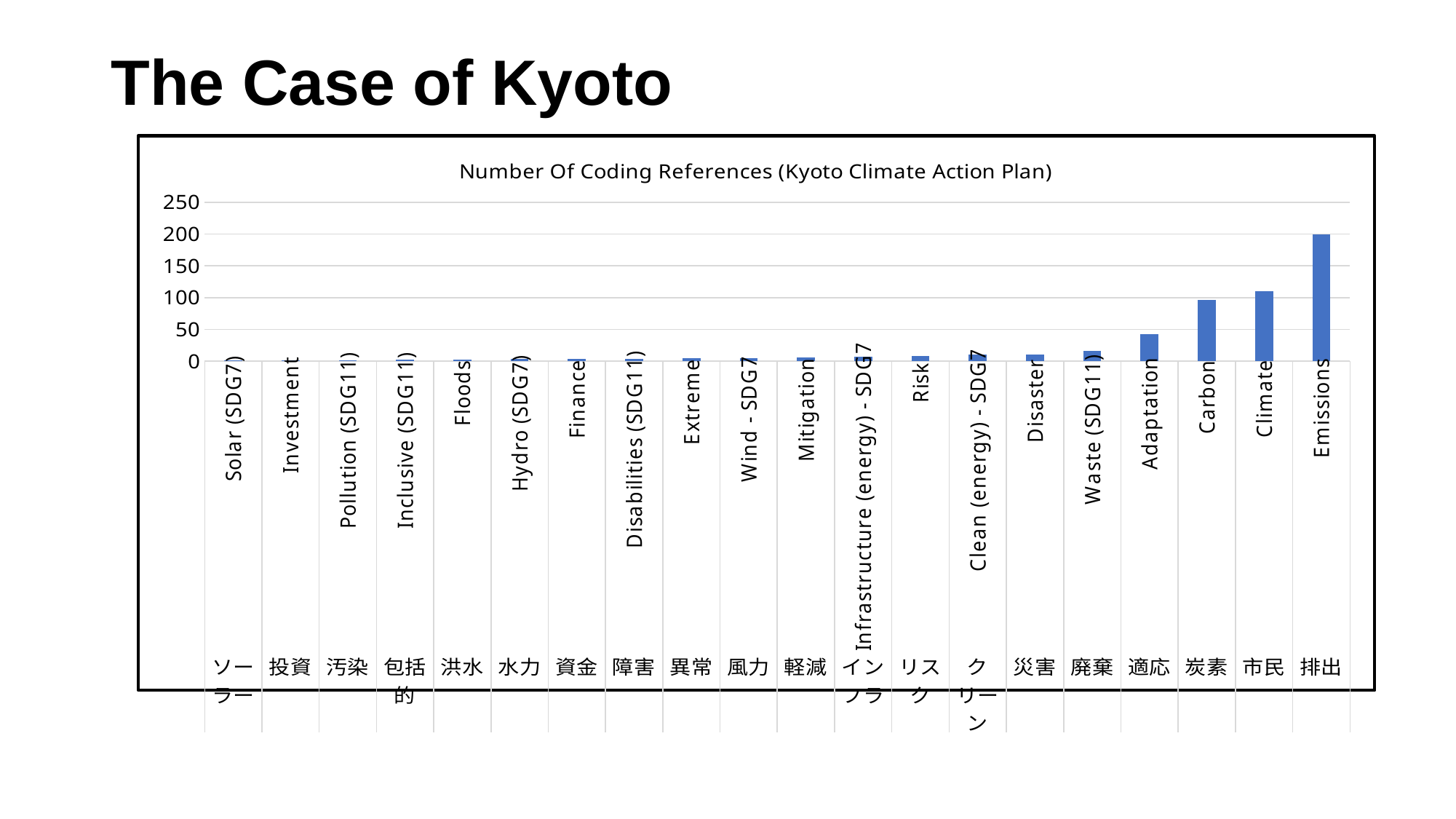
How many categories are plotted on the x axis of the chart? 20 Is the value for Climate greater or less than 100? greater Do the bar values generally rise or fall from left to right along the x axis? Rise Is the value for Carbon greater or less than 50? greater Which has more coding references, Emissions or Climate? Emissions Is the value for Waste (SDG11) greater or less than 50? less What is the title of the chart? Number Of Coding References (Kyoto Climate Action Plan) What type of chart is shown on the slide? Bar chart Which category has the highest number of coding references? Emissions Which has more coding references, Carbon or Adaptation? Carbon